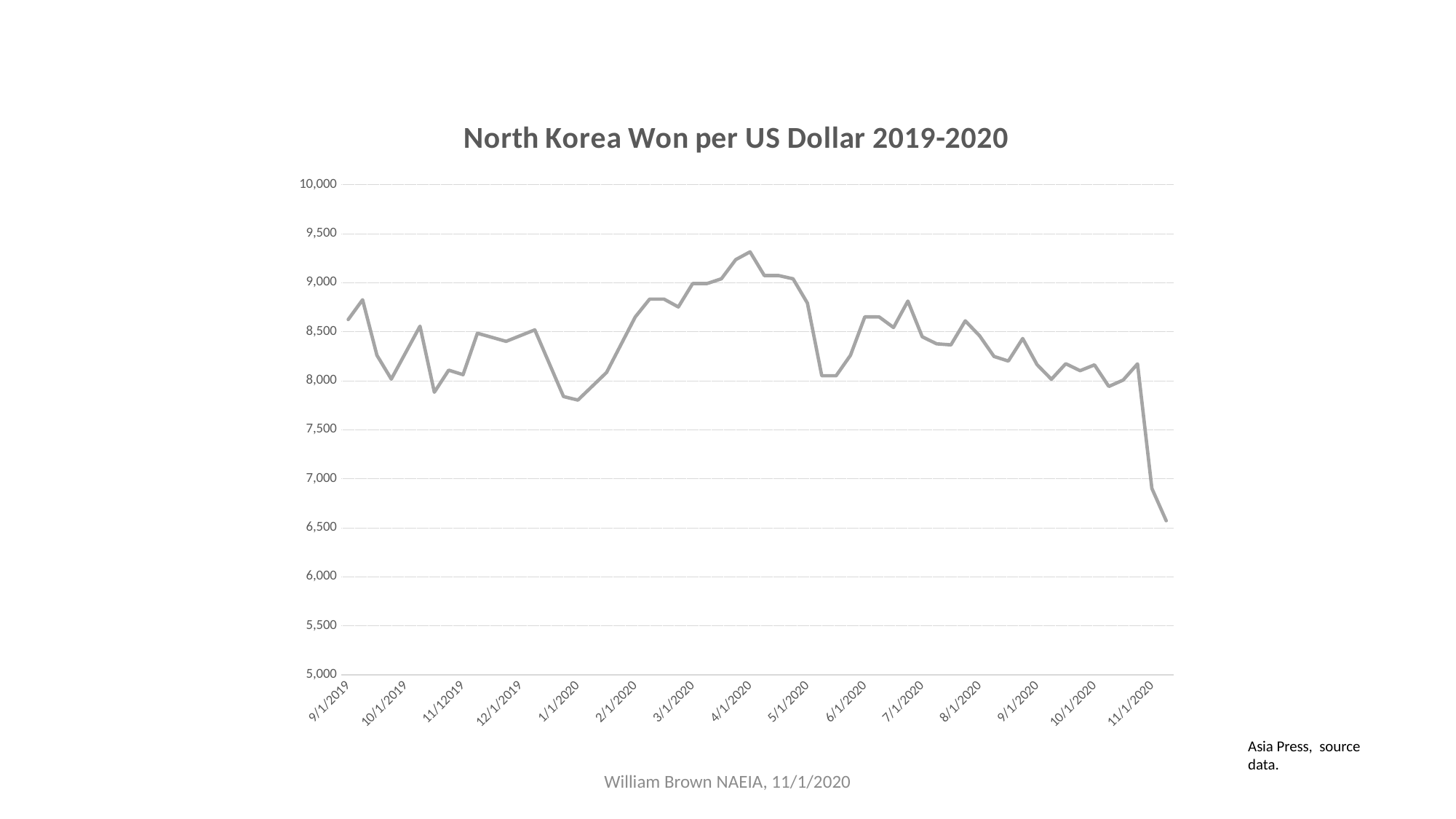
How many date labels are shown on the x axis? 15 What kind of chart is shown on the slide? line chart Is the value at the final point of the line (after 11/1/2020) greater or less than 7,000? less Which has the larger value, 4/1/2020 or 1/1/2020? 4/1/2020 Is the value for 1/1/2020 greater or less than 8,000? less Is the value for 9/1/2019 greater or less than 8,500? greater Does the line rise or fall from 10/1/2020 to the end of the series? fall Does the line rise or fall between 1/1/2020 and 4/1/2020? rise What is the title of the chart? North Korea Won per US Dollar 2019-2020 Which has the larger value, 9/1/2019 or the final point of the line? 9/1/2019